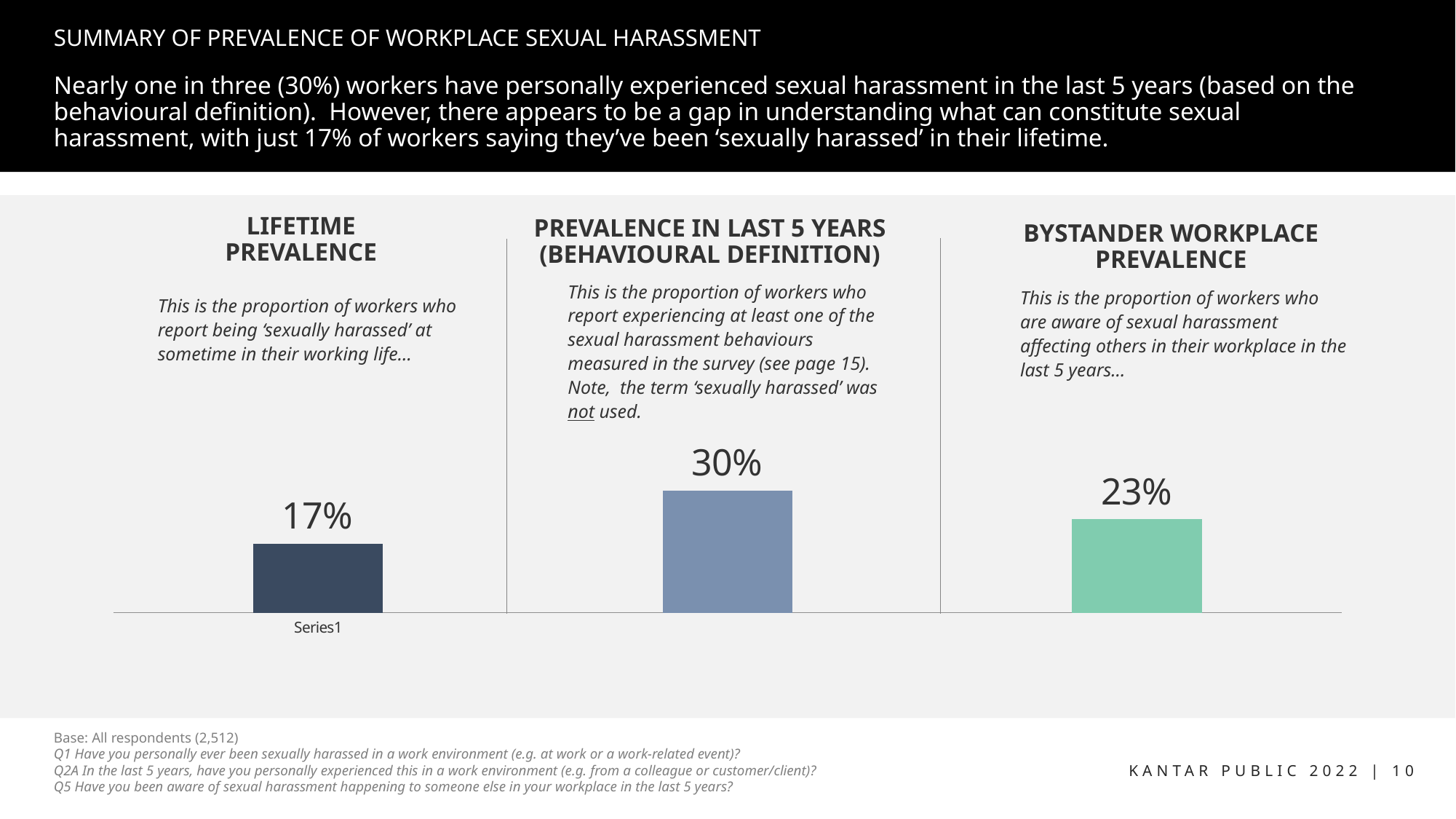
What value is shown for Bystander Workplace Prevalence? 23% How many bars are plotted on the slide? 3 What is the difference between the Prevalence in Last 5 Years value and the Lifetime Prevalence value? 13% What series label appears beneath the Lifetime Prevalence bar? Series1 Which of the three prevalence measures has the highest value? Prevalence in Last 5 Years (Behavioural Definition) Which is larger, the Prevalence in Last 5 Years value or the Bystander Workplace Prevalence value? Prevalence in Last 5 Years What value is shown for Lifetime Prevalence? 17% What is the difference between the Bystander Workplace Prevalence value and the Lifetime Prevalence value? 6% What kind of chart is used to show the prevalence values? Bar chart What value is shown for Prevalence in Last 5 Years (Behavioural Definition)? 30% Which of the three prevalence measures has the lowest value? Lifetime Prevalence Which is larger, the Bystander Workplace Prevalence value or the Lifetime Prevalence value? Bystander Workplace Prevalence